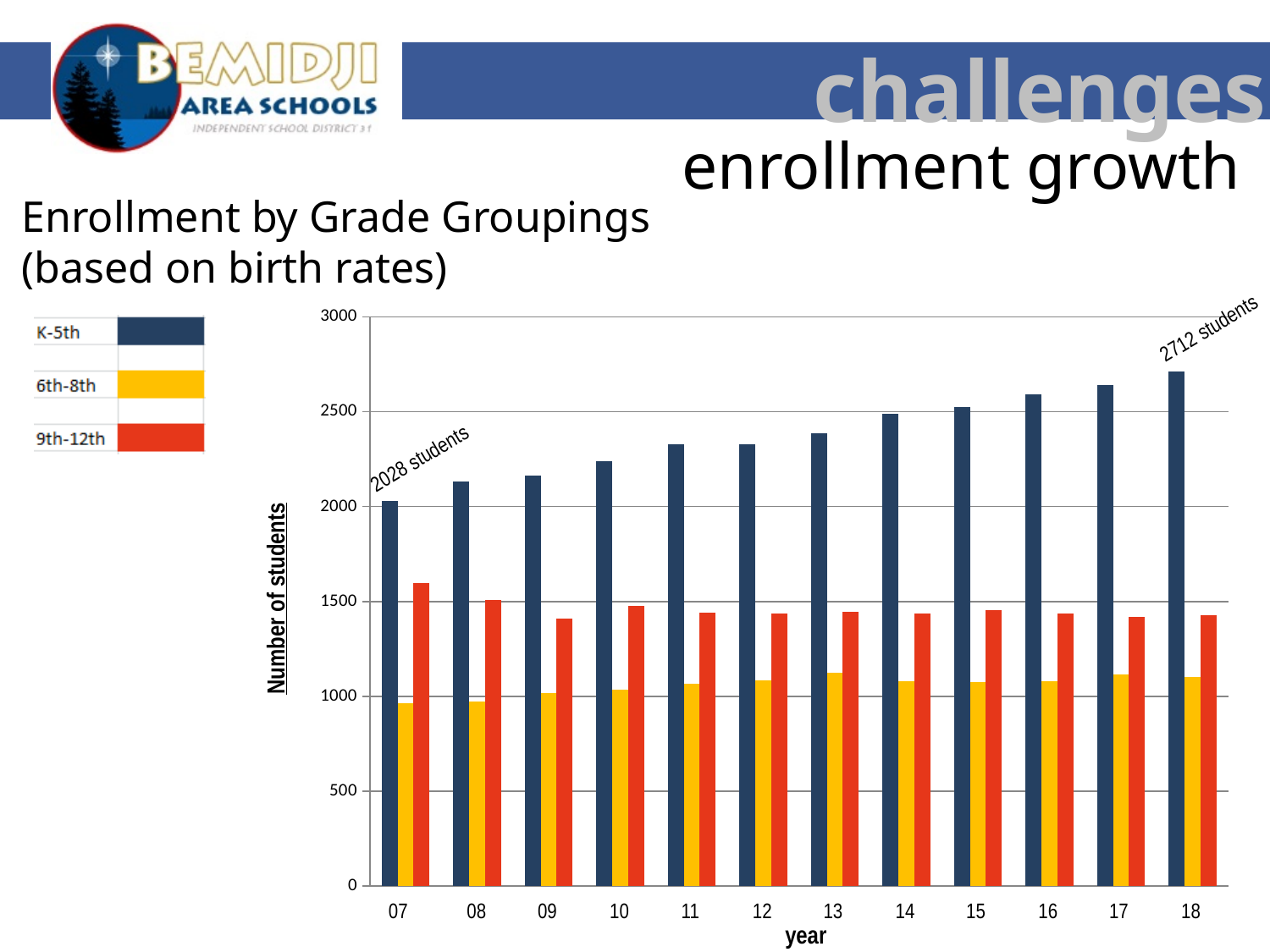
Is the 9th-12th enrollment for year 07 greater or less than 1500? greater Does K-5th enrollment generally rise or fall from 07 to 18? rise Which year has the highest K-5th enrollment? 18 In year 07, which is larger: K-5th enrollment or 9th-12th enrollment? K-5th By how many students does the K-5th enrollment in 18 exceed that in 07? 684 What is the K-5th enrollment shown for year 07? 2028 students What is the K-5th enrollment shown for year 18? 2712 students What kind of chart is shown on the slide? bar chart How many grade groupings (series) does the legend list? 3 What is the label on the vertical axis of the chart? Number of students Which year has the lowest K-5th enrollment? 07 How many years are shown along the x axis of the chart? 12